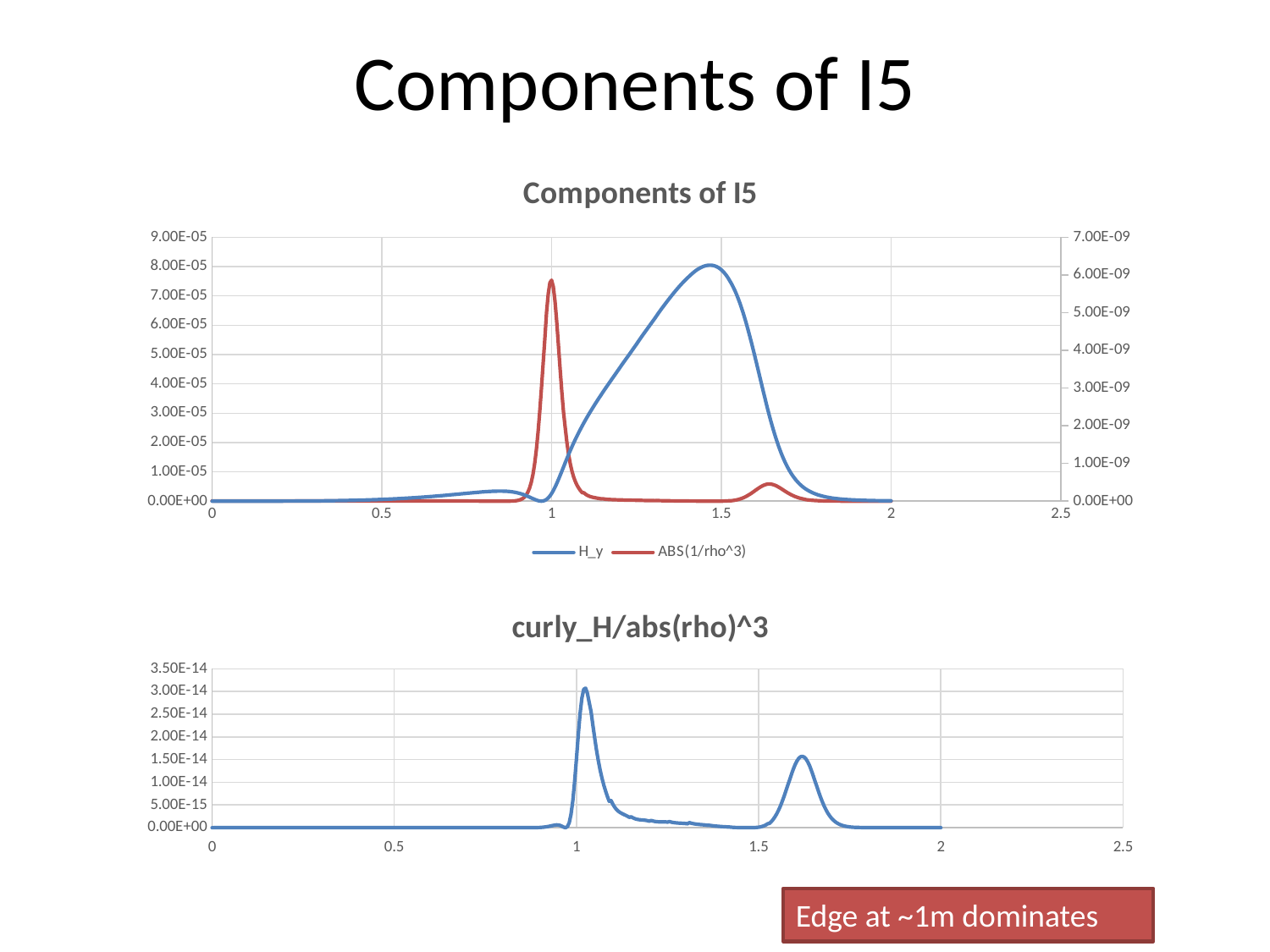
What are the two series named in the legend of the top chart "Components of I5"? H_y and ABS(1/rho^3) In the bottom chart "curly_H/abs(rho)^3", is the second peak (near x = 1.6) greater or less than 2.00E-14? less What kind of chart is the top chart titled "Components of I5"? line chart In the top chart "Components of I5", is the peak value of the H_y series (read on the left axis) greater or less than 7.00E-05? greater What is the title of the bottom chart? curly_H/abs(rho)^3 In the bottom chart "curly_H/abs(rho)^3", which peak is larger: the one near x = 1 or the one near x = 1.6? the one near x = 1 In the top chart "Components of I5", is the value of the small second bump of the ABS(1/rho^3) series near x = 1.65 (read on the right axis) greater or less than 1.00E-09? less In the bottom chart "curly_H/abs(rho)^3", do the values rise or fall along the x axis between x = 1.05 and x = 1.5? fall How many series does the legend of the top chart "Components of I5" list? 2 In the top chart "Components of I5", which series is drawn in red? ABS(1/rho^3)